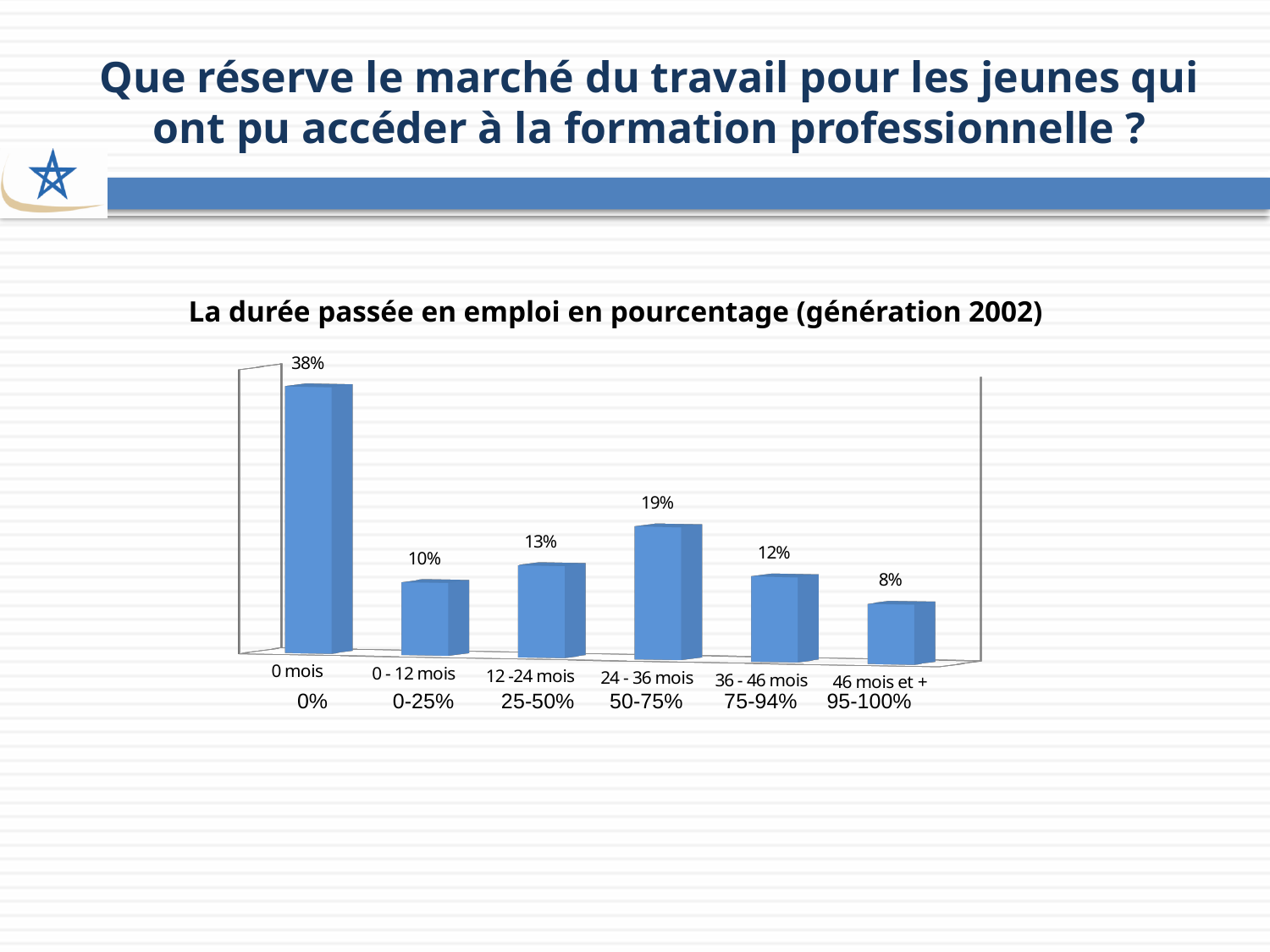
What is the title of the chart? La durée passée en emploi en pourcentage (génération 2002) Which category has the highest value? 0 mois What is the value for the "0 - 12 mois" category? 10% What is the difference between the values for "0 mois" and "24 - 36 mois"? 19% What is the value for the "0 mois" category? 38% Which category has the lowest value? 46 mois et + What is the value for the "46 mois et +" category? 8% How many categories are shown in the chart? 6 What is the difference between the values for "12 -24 mois" and "36 - 46 mois"? 1% What kind of chart is shown on the slide? Bar chart Which is larger, the value for "24 - 36 mois" or the value for "36 - 46 mois"? 24 - 36 mois What is the value for the "24 - 36 mois" category? 19%